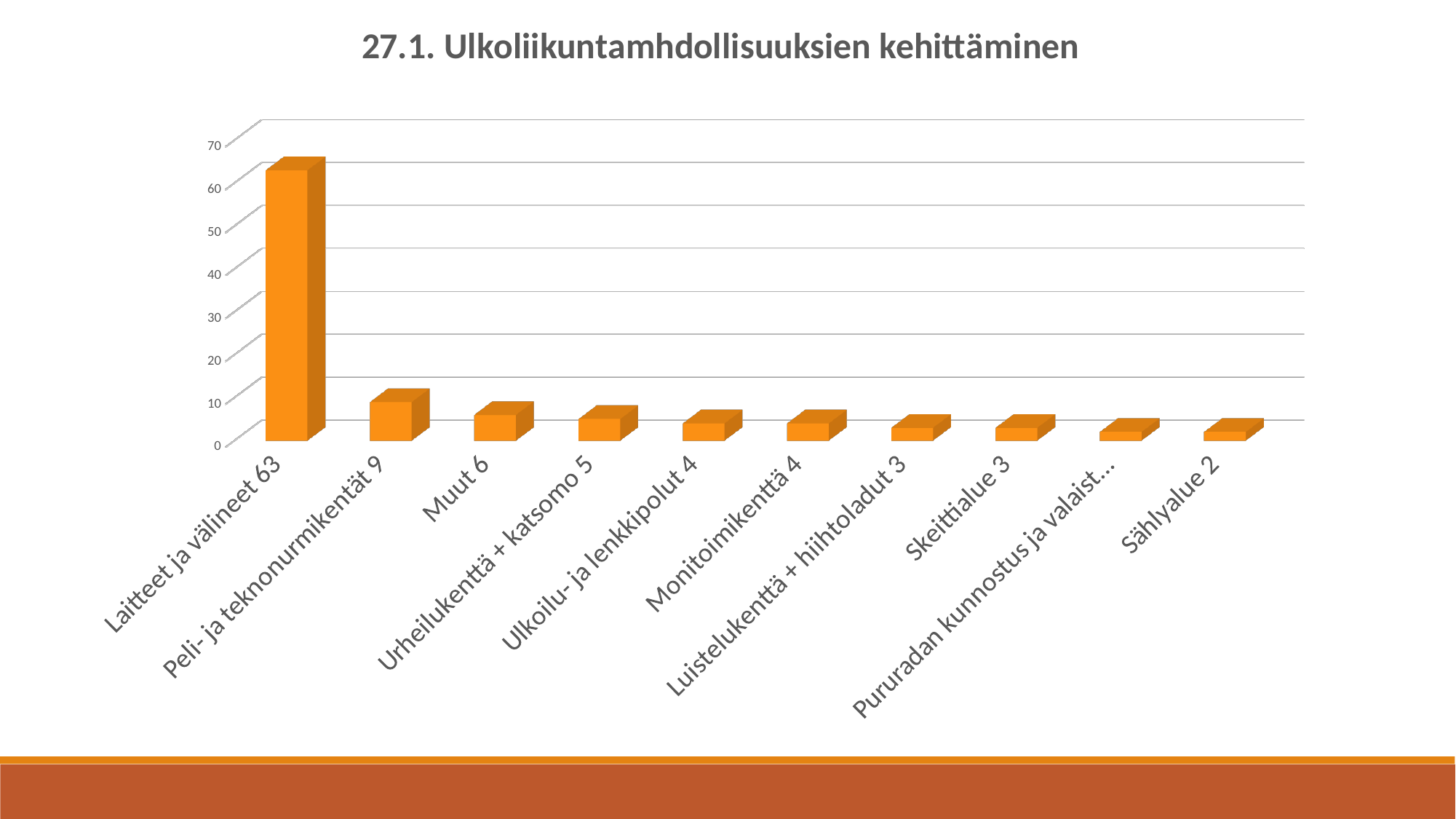
What is the value for Sählyalue? 2 What kind of chart is shown on the slide? Bar chart What is the value for Laitteet ja välineet? 63 What is the difference between the values for Laitteet ja välineet and Peli- ja teknonurmikentät? 54 Is the value for Laitteet ja välineet greater or less than 60? greater Which is larger, the value for Muut or the value for Skeittialue? Muut What is the value for Peli- ja teknonurmikentät? 9 How many categories are shown in the chart? 10 Which category has the highest value? Laitteet ja välineet What is the title of the chart? 27.1. Ulkoliikuntamhdollisuuksien kehittäminen What is the value for Urheilukenttä + katsomo? 5